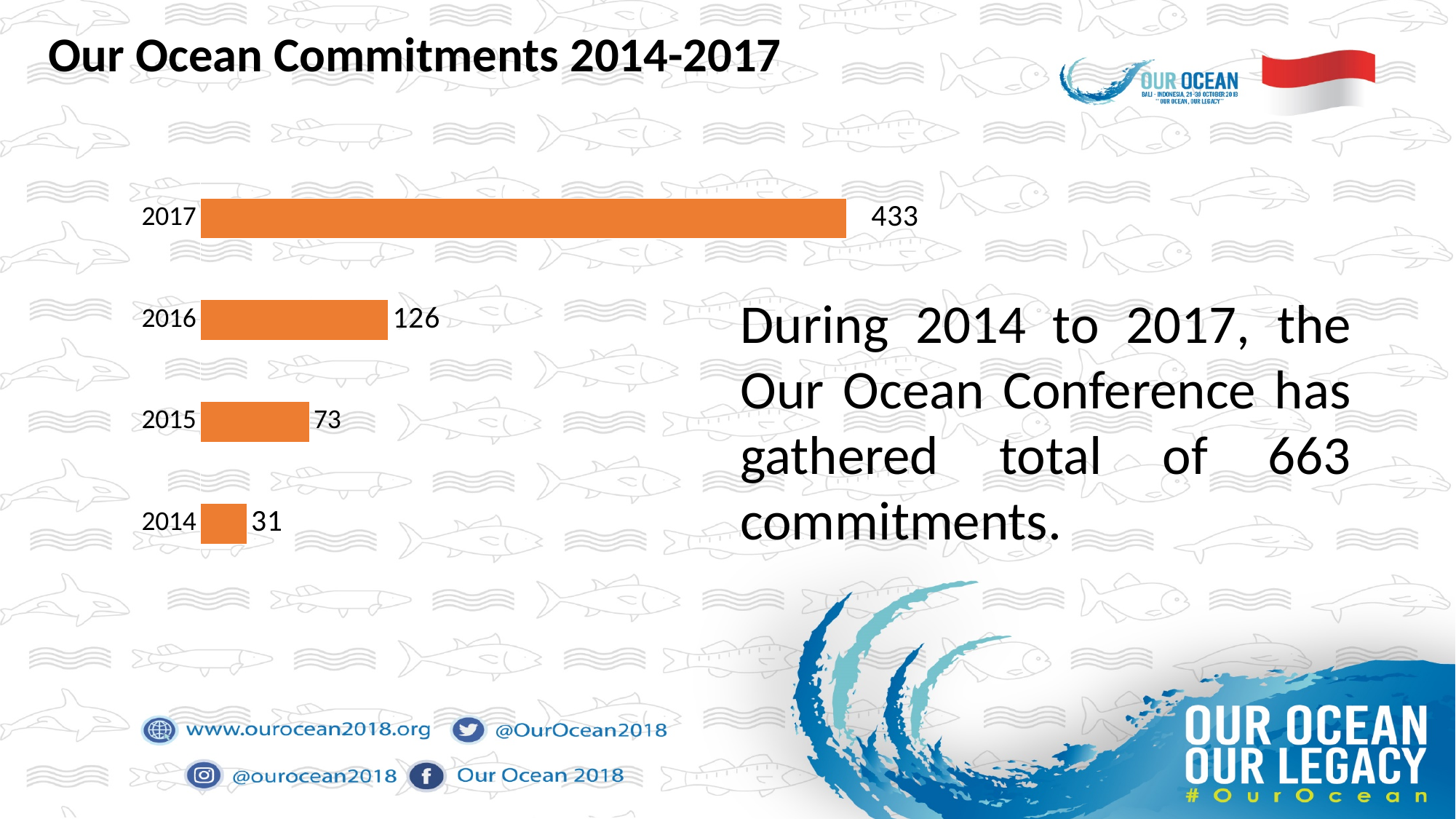
What is the value shown for 2015? 73 What kind of chart is shown on the slide? bar chart What is the difference between the values for 2017 and 2016? 307 How many years are shown in the chart? 4 What colour are the bars in the chart? orange Which is larger, the value for 2015 or the value for 2014? 2015 Which year has the lowest number of commitments? 2014 Do the number of commitments rise or fall from 2014 to 2017? rise What is the difference between the values for 2016 and 2015? 53 Which year has the highest number of commitments? 2017 What is the number of commitments for 2017? 433 What is the number of commitments for 2014? 31